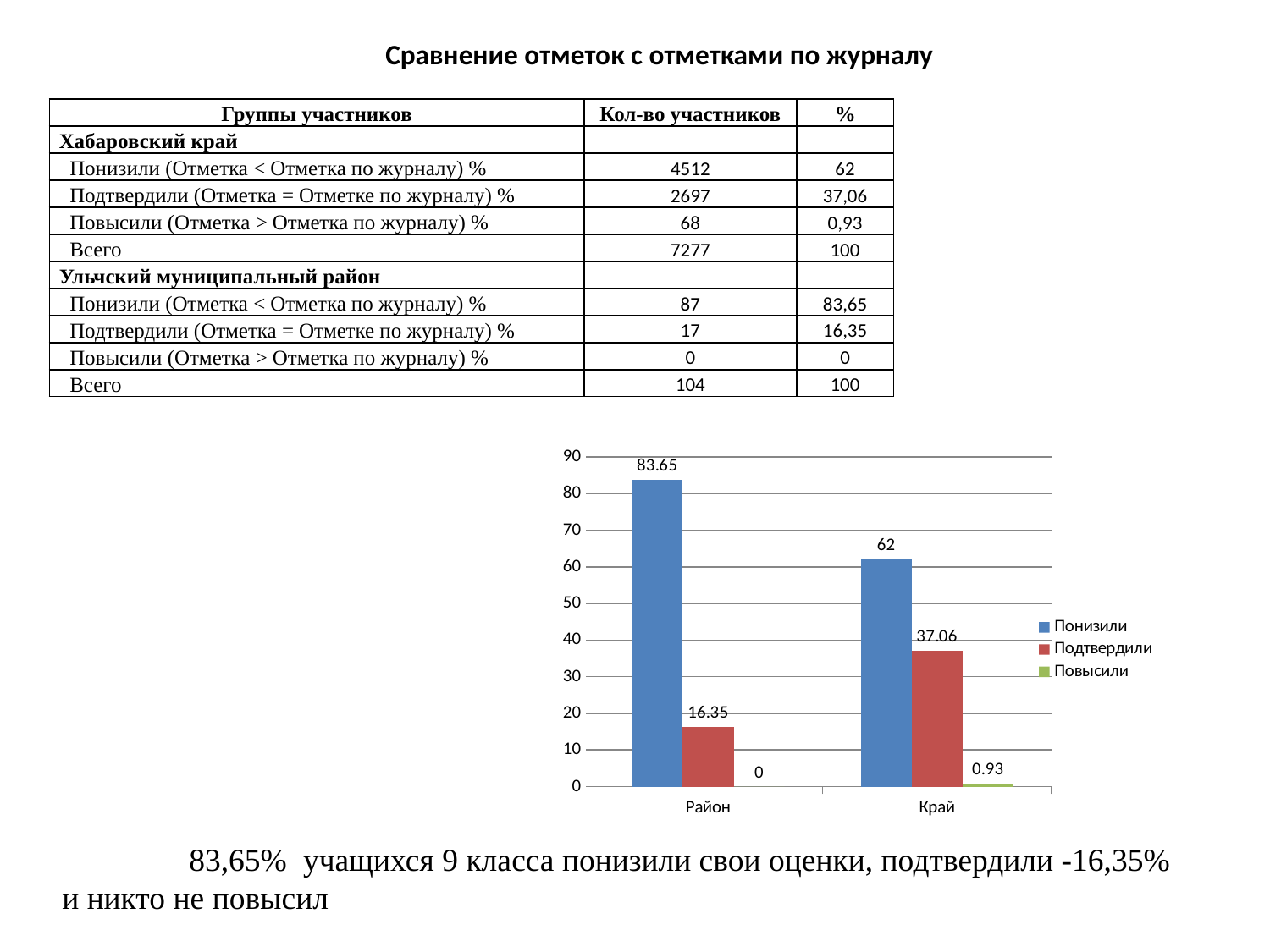
What is the difference between Понизили and Подтвердили for Район in the chart? 67.3 Which series is shown in red in the chart legend? Подтвердили What is the difference between the Подтвердили values for Край and Район in the chart? 20.71 Which series has the lowest value for Край in the chart? Повысили What is the value of Понизили for Район in the chart? 83.65 How many categories are shown on the x axis of the chart? 2 What is the value of Повысили for Край in the chart? 0.93 What type of chart is shown on the slide? bar chart What is the value of Повысили for Район in the chart? 0 Which category has the higher value for Понизили in the chart? Район What is the value of Подтвердили for Край in the chart? 37.06 How many series does the chart legend list? 3